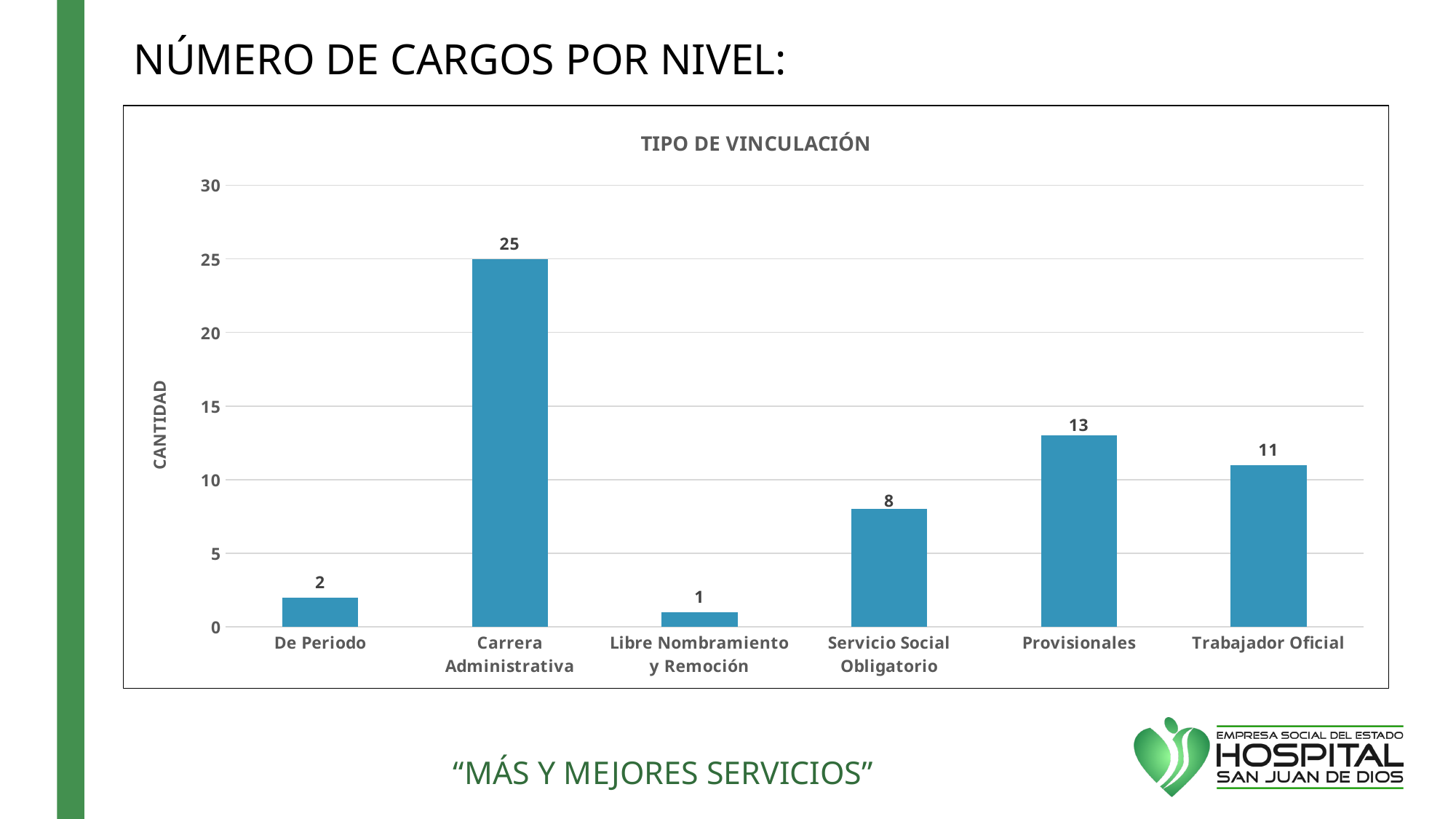
How many categories are shown on the x axis? 6 What is the value for Provisionales? 13 Which is larger, the value for Servicio Social Obligatorio or the value for De Periodo? Servicio Social Obligatorio What is the value for Carrera Administrativa? 25 What kind of chart is shown on the slide? bar chart What is the title of the chart? TIPO DE VINCULACIÓN Is the value for Trabajador Oficial greater or less than 10? greater What is the label of the vertical axis? CANTIDAD Which category has the highest value? Carrera Administrativa What is the difference between the values for Provisionales and Trabajador Oficial? 2 Which category has the lowest value? Libre Nombramiento y Remoción What is the value for Libre Nombramiento y Remoción? 1